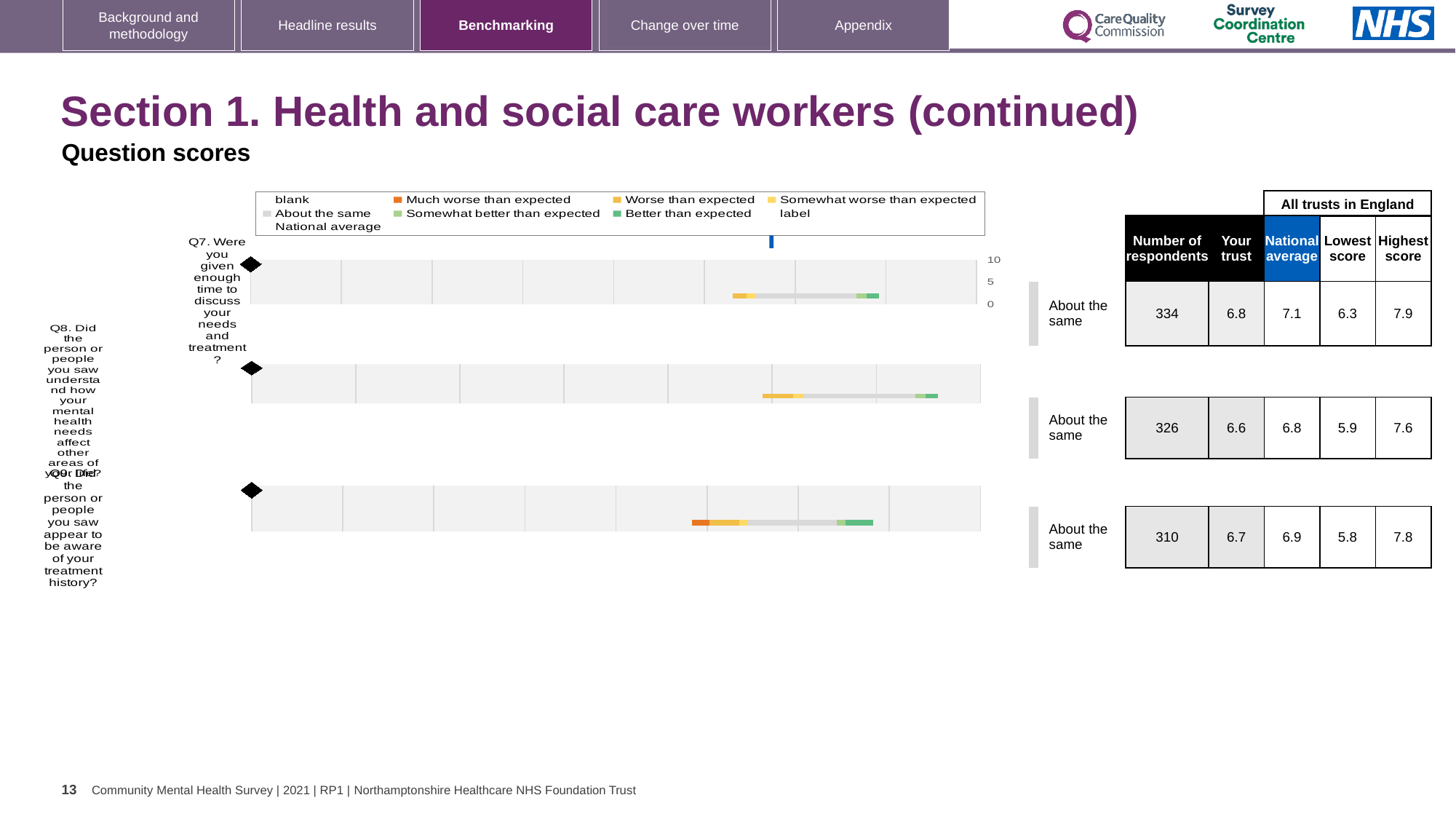
For Q7, which is larger: the 'Your trust' score or the national average? National average How many questions (Q7, Q8, Q9) are plotted on this slide? 3 What benchmark category label is shown next to the Q7 chart? About the same What kind of chart is used to show the question scores on this slide? bar chart What is the highest score among all trusts in England for Q8? 7.6 Which question has the lowest 'Lowest score' among all trusts in England? Q9 How many respondents answered Q9 (Did the person or people you saw appear to be aware of your treatment history?)? 310 Which question has the highest 'Your trust' score? Q7 What is the 'Your trust' score for Q7 (Were you given enough time to discuss your needs and treatment?)? 6.8 For Q8, how much higher is the national average than the 'Your trust' score? 0.2 What is the national average score for Q8 (Did the person or people you saw understand how your mental health needs affect other areas of your life?)? 6.8 For Q9, what is the difference between the highest score and the lowest score across all trusts in England? 2.0